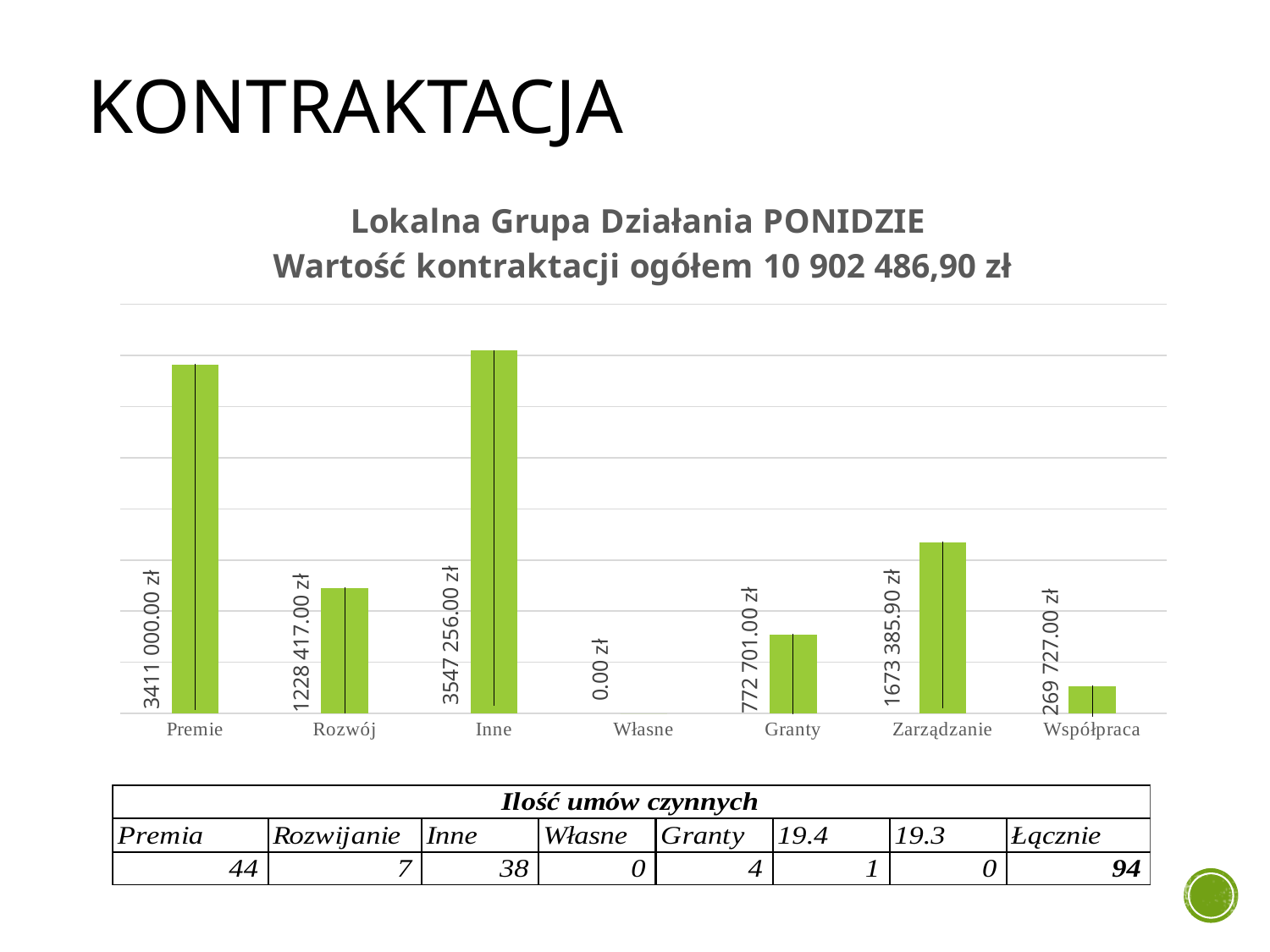
Which category has the lowest value? Własne What kind of chart is shown on the slide? Bar chart What total contract value is stated in the chart title? 10 902 486,90 zł What is the value for Granty? 772 701.00 zł What is the value for Współpraca? 269 727.00 zł Which category has the highest value? Inne How many categories are shown on the x axis? 7 What is the value for Zarządzanie? 1 673 385.90 zł Which is larger, the value for Rozwój or the value for Granty? Rozwój What is the difference between the values for Zarządzanie and Rozwój? 444 968.90 zł What is the value for Premie? 3 411 000.00 zł What is the difference between the values for Inne and Premie? 136 256.00 zł